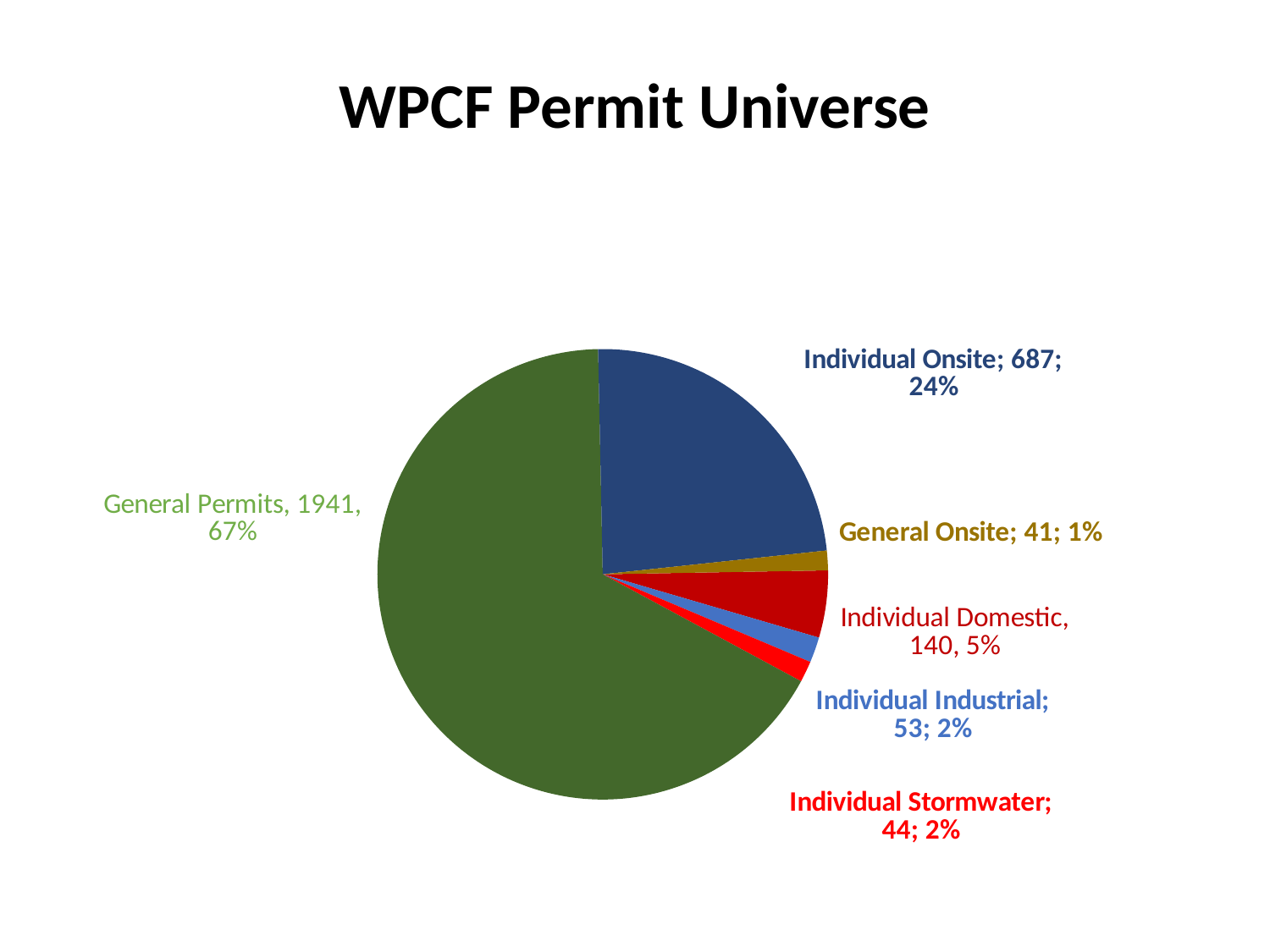
What is the title of the chart? WPCF Permit Universe How many slices does the pie chart have? 6 What is the value for Individual Onsite? 687 Which category has the largest slice? General Permits What type of chart is shown on the slide? pie chart What share of the pie does Individual Onsite represent? 24% What is the value for Individual Domestic? 140 What is the difference between the values for Individual Onsite and Individual Domestic? 547 What is the value for Individual Industrial? 53 Which is larger, Individual Industrial or Individual Stormwater? Individual Industrial Which category has the smallest slice? General Onsite What is the value for General Permits? 1941